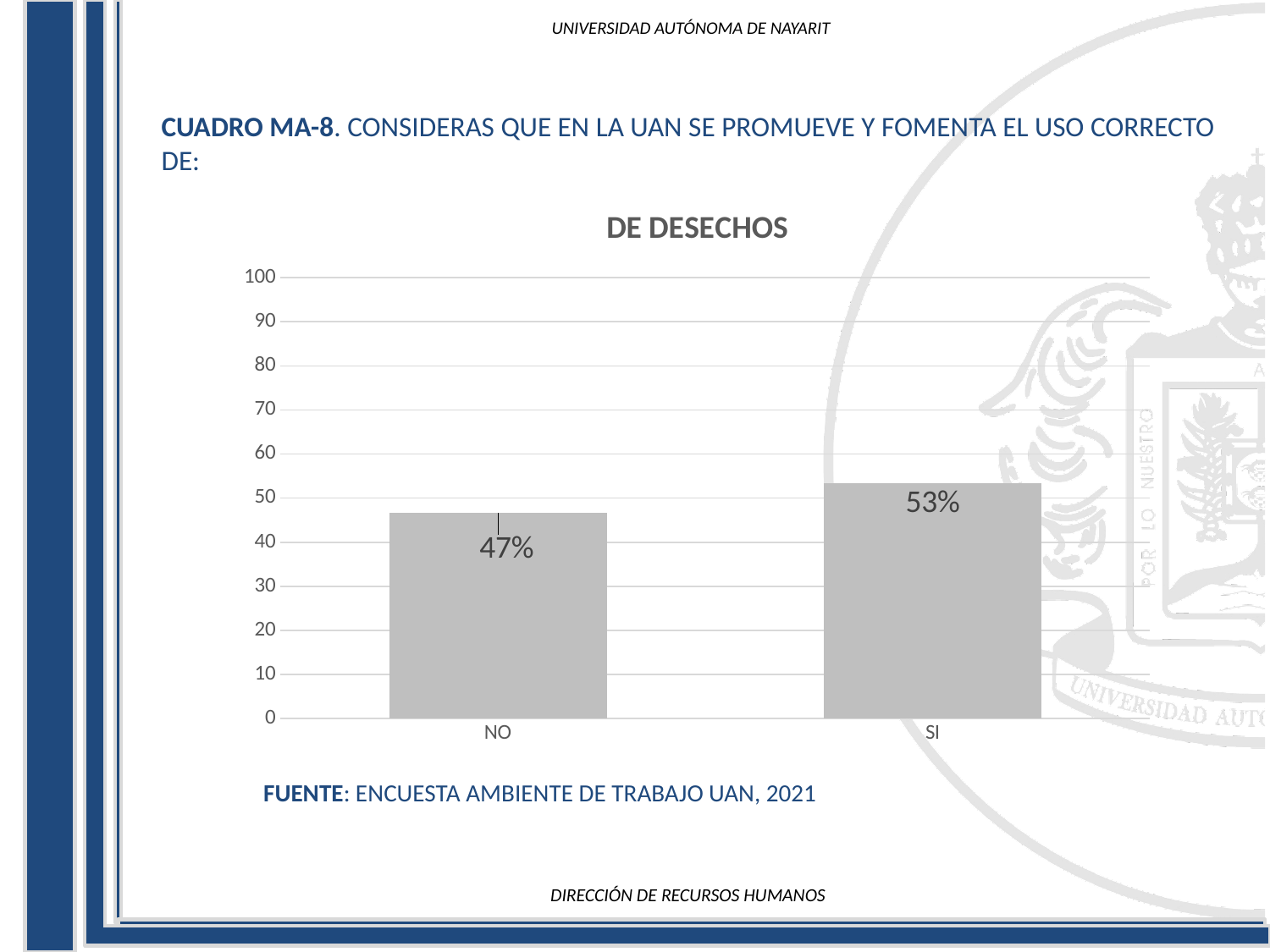
What kind of chart is shown? bar chart What is the highest value shown on the y axis? 100 What is the difference between the values for SI and NO? 6% Is the value for NO greater or less than 50? less Is the value for SI greater or less than 50? greater What is the value for NO? 47% What is the value for SI? 53% Which category has the highest value? SI What is the title of the chart? DE DESECHOS Which category has the lowest value? NO Which is larger, the value for NO or the value for SI? SI How many categories are shown on the x axis? 2